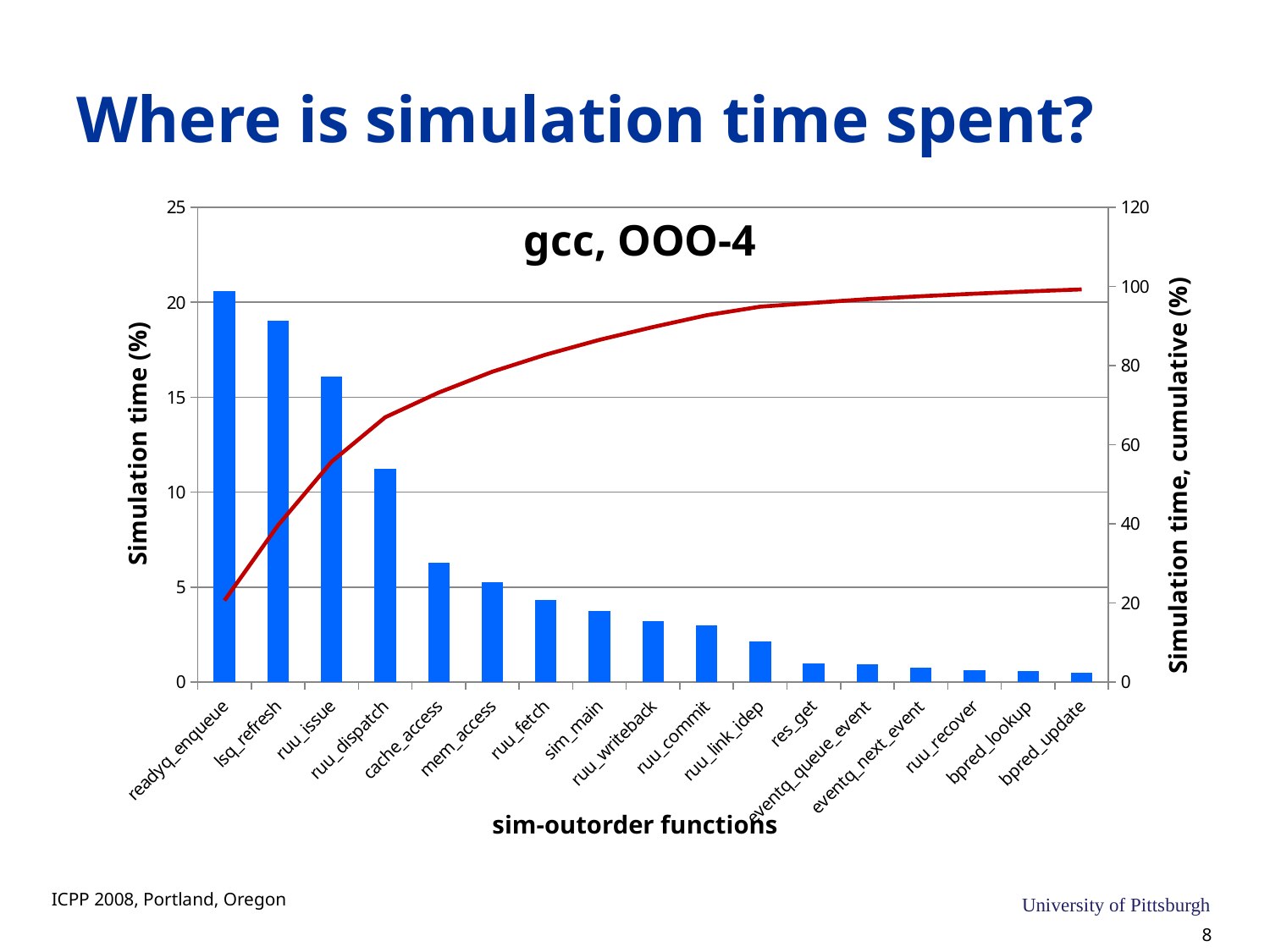
Do the bar values rise or fall moving from left to right along the x axis? fall How many sim-outorder functions are plotted along the x axis? 17 What is the label of the right-hand vertical axis? Simulation time, cumulative (%) Is the simulation time for ruu_issue greater or less than 15? greater Is the simulation time for ruu_dispatch greater or less than 10? greater What kind of chart is shown on the slide? bar chart with a cumulative line Is the simulation time for ruu_fetch greater or less than 5? less Which has a larger simulation time, ruu_commit or res_get? ruu_commit Which has a larger simulation time, cache_access or mem_access? cache_access What is the title shown inside the chart area? gcc, OOO-4 Which function has the highest simulation time (%)? readyq_enqueue